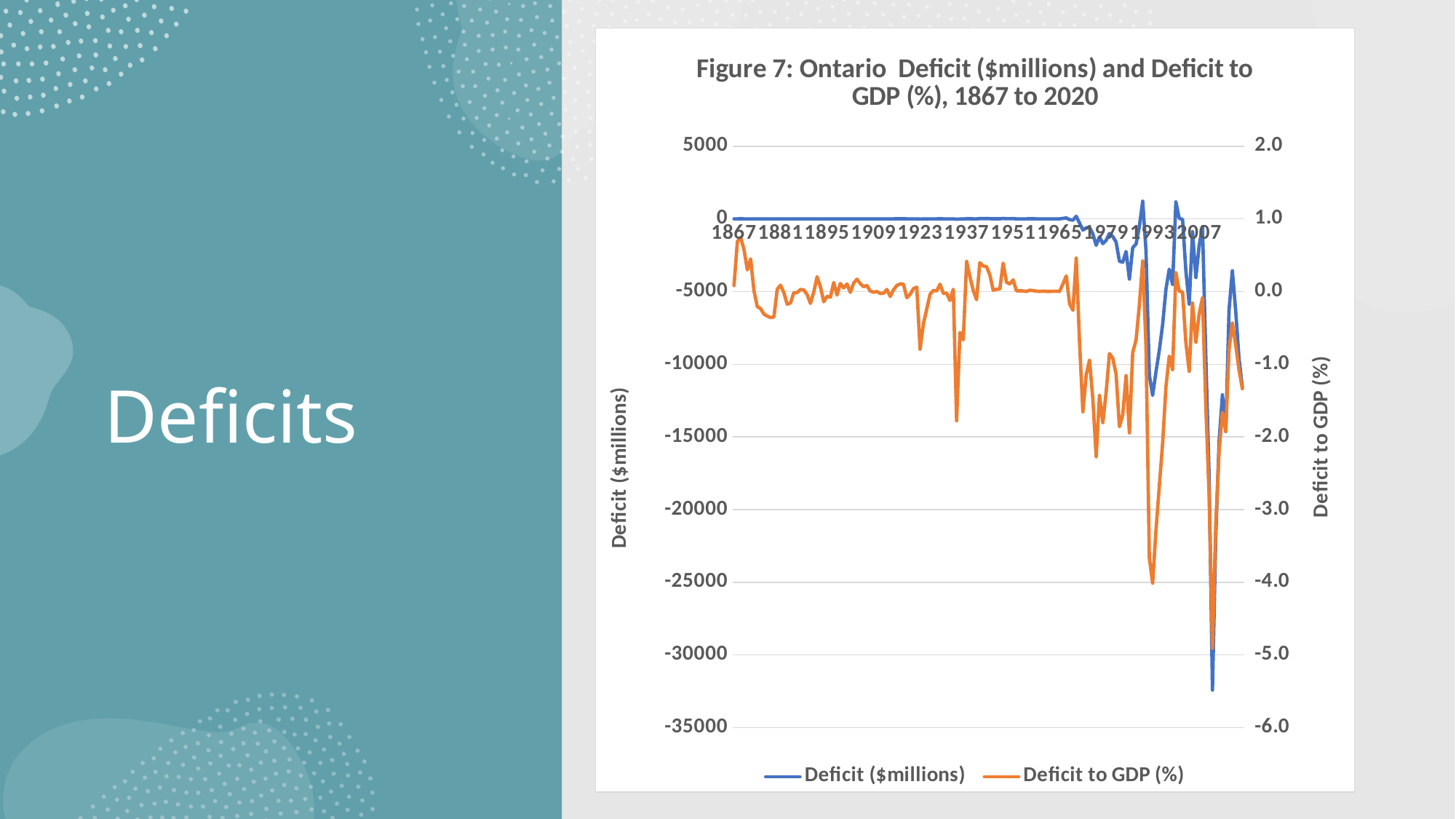
How many year labels are shown along the x axis? 11 How many series does the legend list? 2 What kind of chart is shown on the slide? line chart Is the lowest value reached by the Deficit ($millions) line greater or less than -30000? less Is the lowest value reached by the Deficit to GDP (%) line greater or less than -3.0? less Is the Deficit to GDP (%) value in 1867 greater or less than -1.0? greater What figure number is given in the chart title? Figure 7 Does the Deficit ($millions) line generally rise or fall from the 1960s to the end of the period? fall Which series is plotted against the right-hand axis labelled "Deficit to GDP (%)"? Deficit to GDP (%)